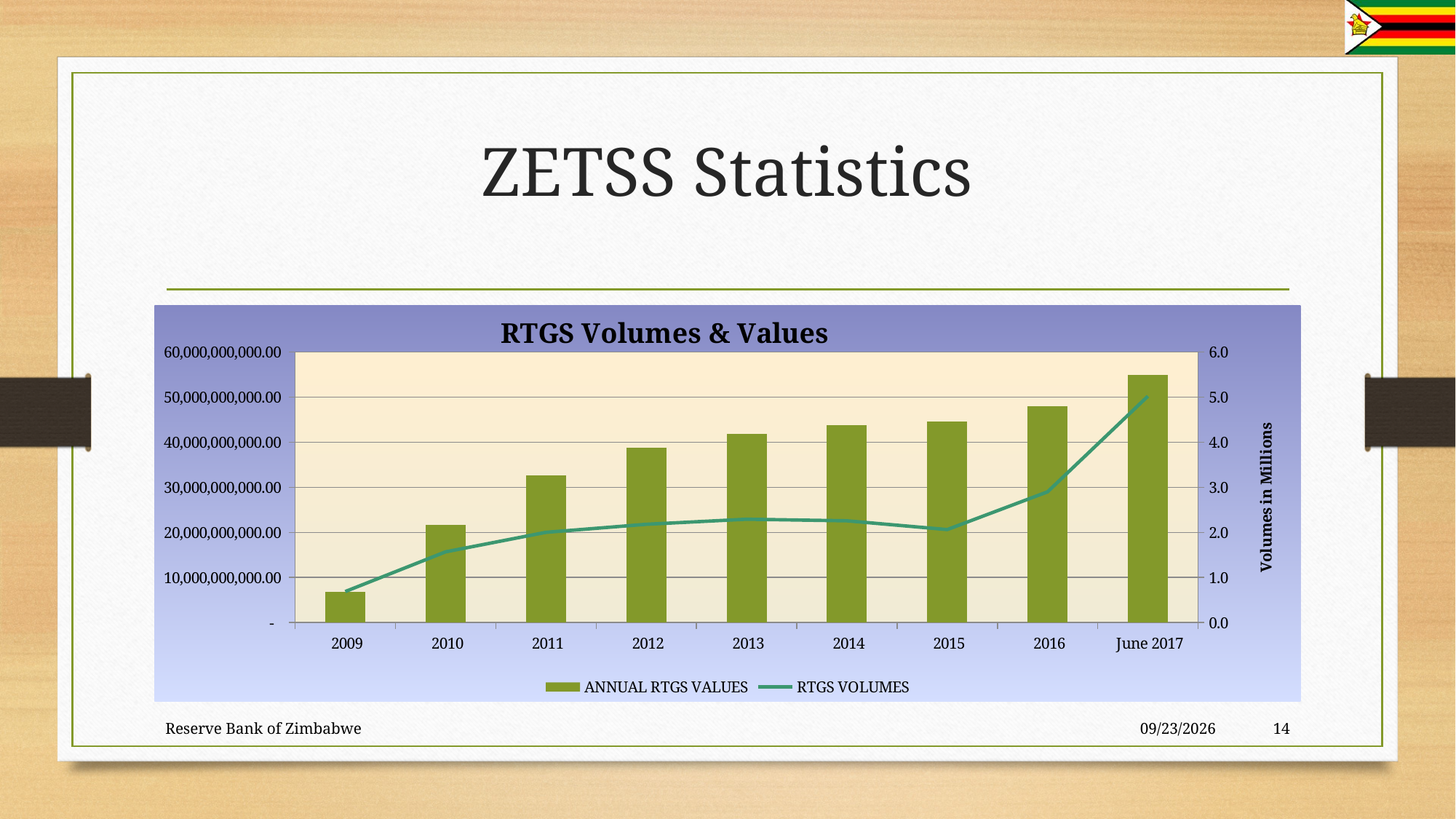
Is the ANNUAL RTGS VALUES bar for June 2017 greater or less than 50,000,000,000.00? greater Which category has the highest ANNUAL RTGS VALUES bar? June 2017 What kind of chart is this? Combined bar and line chart How many series does the legend list? 2 What is the title of the chart? RTGS Volumes & Values Is the RTGS VOLUMES value for 2010 greater or less than 1.0 million? greater Which has the larger ANNUAL RTGS VALUES bar, 2011 or 2014? 2014 How many categories are shown on the x axis? 9 Is the ANNUAL RTGS VALUES bar for 2009 greater or less than 10,000,000,000.00? less Do the ANNUAL RTGS VALUES bars rise or fall from 2009 to June 2017? Rise Which category has the lowest ANNUAL RTGS VALUES bar? 2009